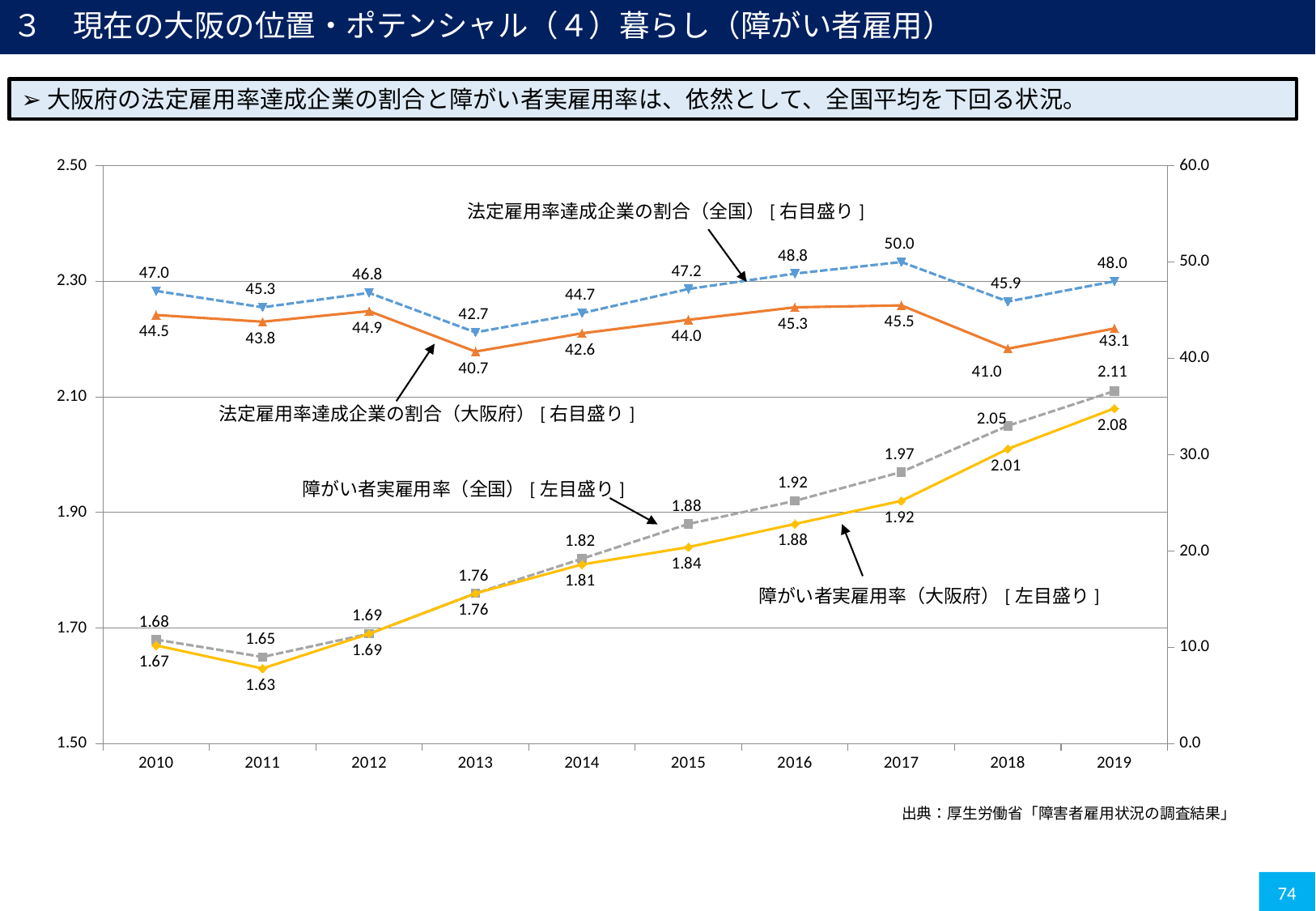
Which is larger in 2016: 障がい者実雇用率（全国） or 障がい者実雇用率（大阪府）? 障がい者実雇用率（全国） In which year is 法定雇用率達成企業の割合（全国） highest? 2017 Which series is plotted with a blue dashed line? 法定雇用率達成企業の割合（全国）[右目盛り] What is the value of 法定雇用率達成企業の割合（大阪府） in 2013? 40.7 Does 障がい者実雇用率（全国） rise or fall from 2013 to 2019? rise What is the difference between 障がい者実雇用率（全国） and 障がい者実雇用率（大阪府） in 2017? 0.05 What is the value of 法定雇用率達成企業の割合（全国） in 2017? 50.0 What is the difference between 法定雇用率達成企業の割合（全国） and 法定雇用率達成企業の割合（大阪府） in 2018? 4.9 What type of chart is shown on the slide? line chart How many years are plotted along the x axis? 10 What is the value of 障がい者実雇用率（大阪府） in 2019? 2.08 In which year is 障がい者実雇用率（大阪府） lowest? 2011